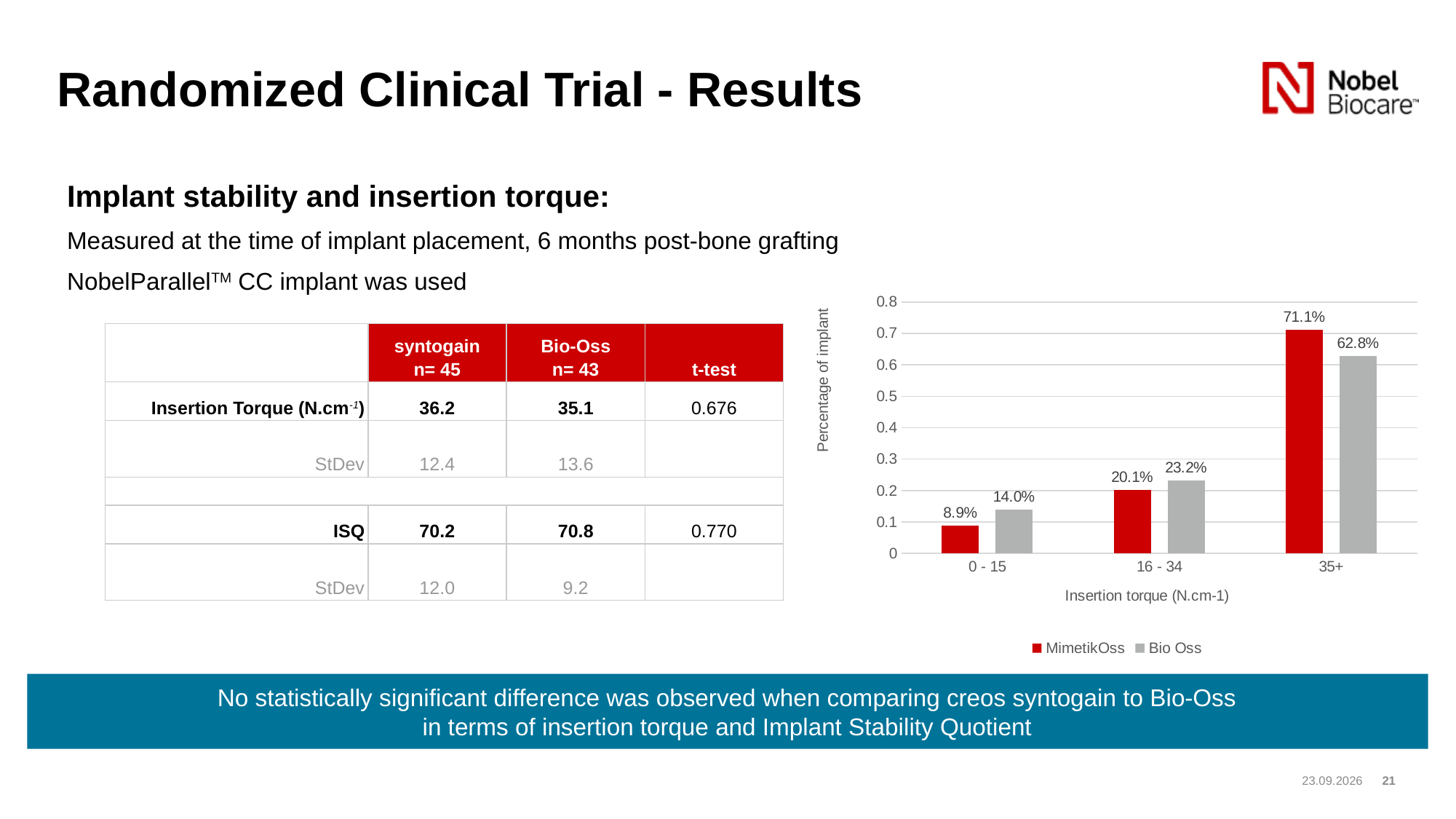
In the 0 - 15 category, which series has the larger value, MimetikOss or Bio Oss? Bio Oss Which insertion torque category has the lowest value for Bio Oss? 0 - 15 How many insertion torque categories are shown on the x axis? 3 Which insertion torque category has the highest value for MimetikOss? 35+ What is the difference between the MimetikOss and Bio Oss values in the 35+ category? 8.3% What is the value for MimetikOss in the 0 - 15 insertion torque category? 8.9% What is the value for Bio Oss in the 16 - 34 insertion torque category? 23.2% What is the value for Bio Oss in the 35+ insertion torque category? 62.8% What is the value for MimetikOss in the 35+ insertion torque category? 71.1% What kind of chart is shown on the slide? bar chart How many series does the chart legend list? 2 Do the MimetikOss values rise or fall from the 0 - 15 category to the 35+ category? rise